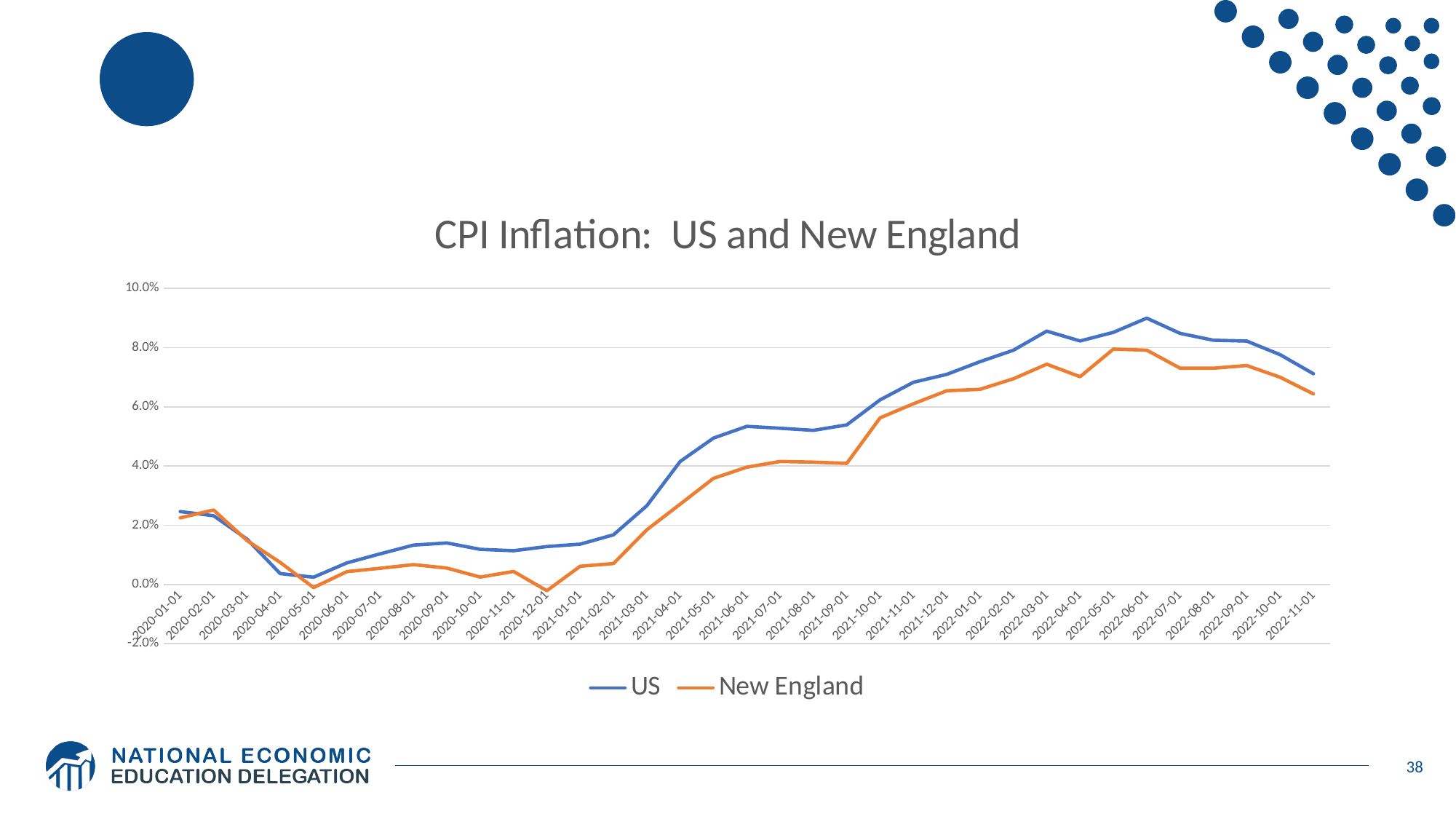
Is the value for US at 2022-06-01 greater or less than 8.0%? greater At which date does the New England series reach its lowest value? 2020-12-01 Is the value for New England at 2020-12-01 greater or less than 0.0%? less How many series does the legend list? 2 Do the US values rise or fall between 2022-06-01 and 2022-11-01? fall How many monthly data points are plotted along the x axis? 35 At which date does the US series reach its highest value? 2022-06-01 Which series is drawn in orange? New England Is the value for New England at 2021-08-01 greater or less than 6.0%? less What kind of chart is shown on the slide? line chart What is the title of the chart? CPI Inflation: US and New England Which series has the higher value at 2022-03-01, US or New England? US